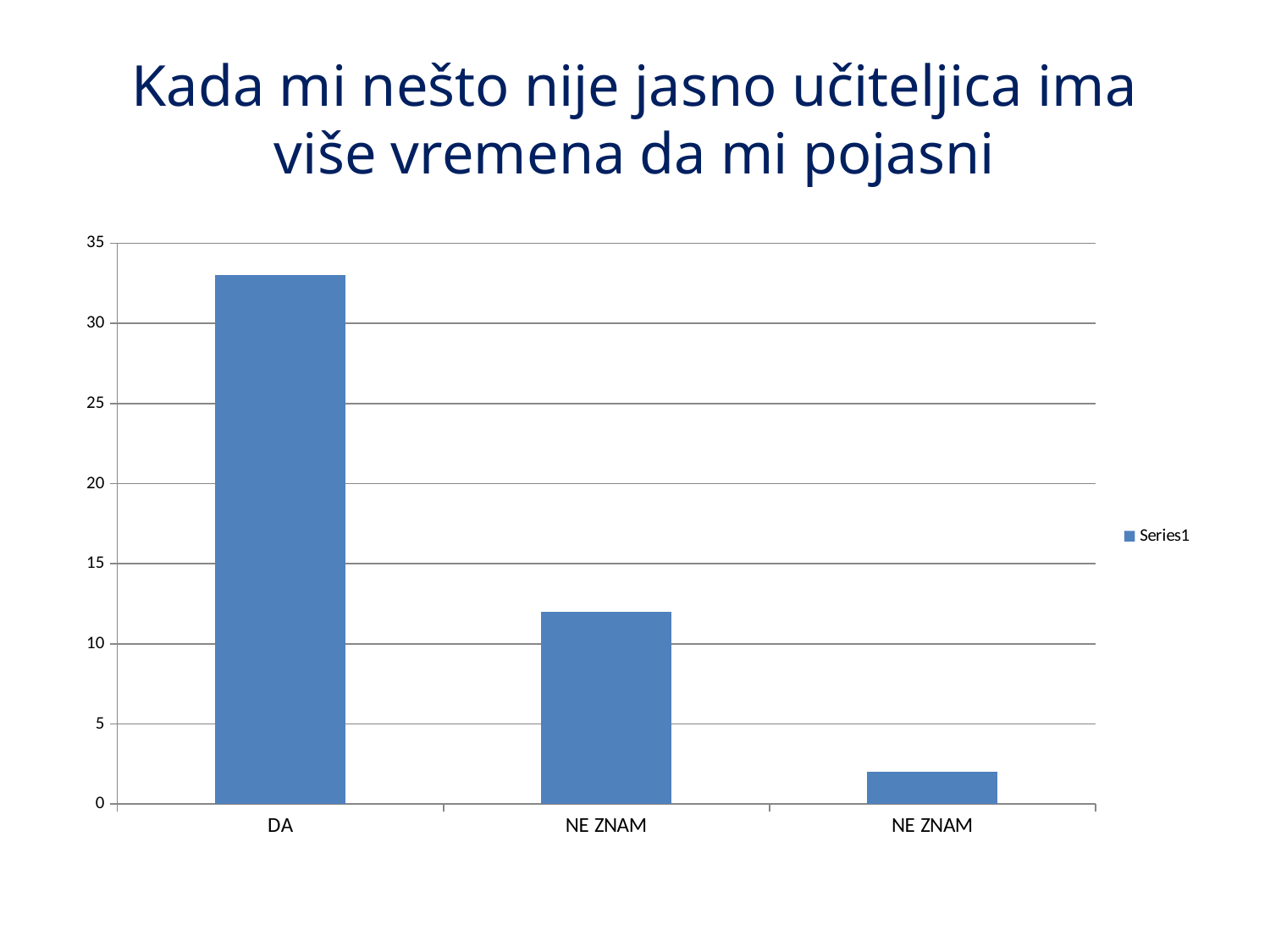
What kind of chart is shown on the slide? bar chart Is the value for DA greater or less than 35? less Is the value for the middle bar (NE ZNAM) greater or less than 15? less Do the bar values rise or fall from left to right across the x axis? fall Is the value for the middle bar (NE ZNAM) greater or less than 10? greater Which is larger, the value for DA or the value for the middle NE ZNAM bar? DA Which category has the highest bar? DA How many series does the legend list? 1 How many bars does the chart show? 3 What is the name of the series shown in the legend? Series1